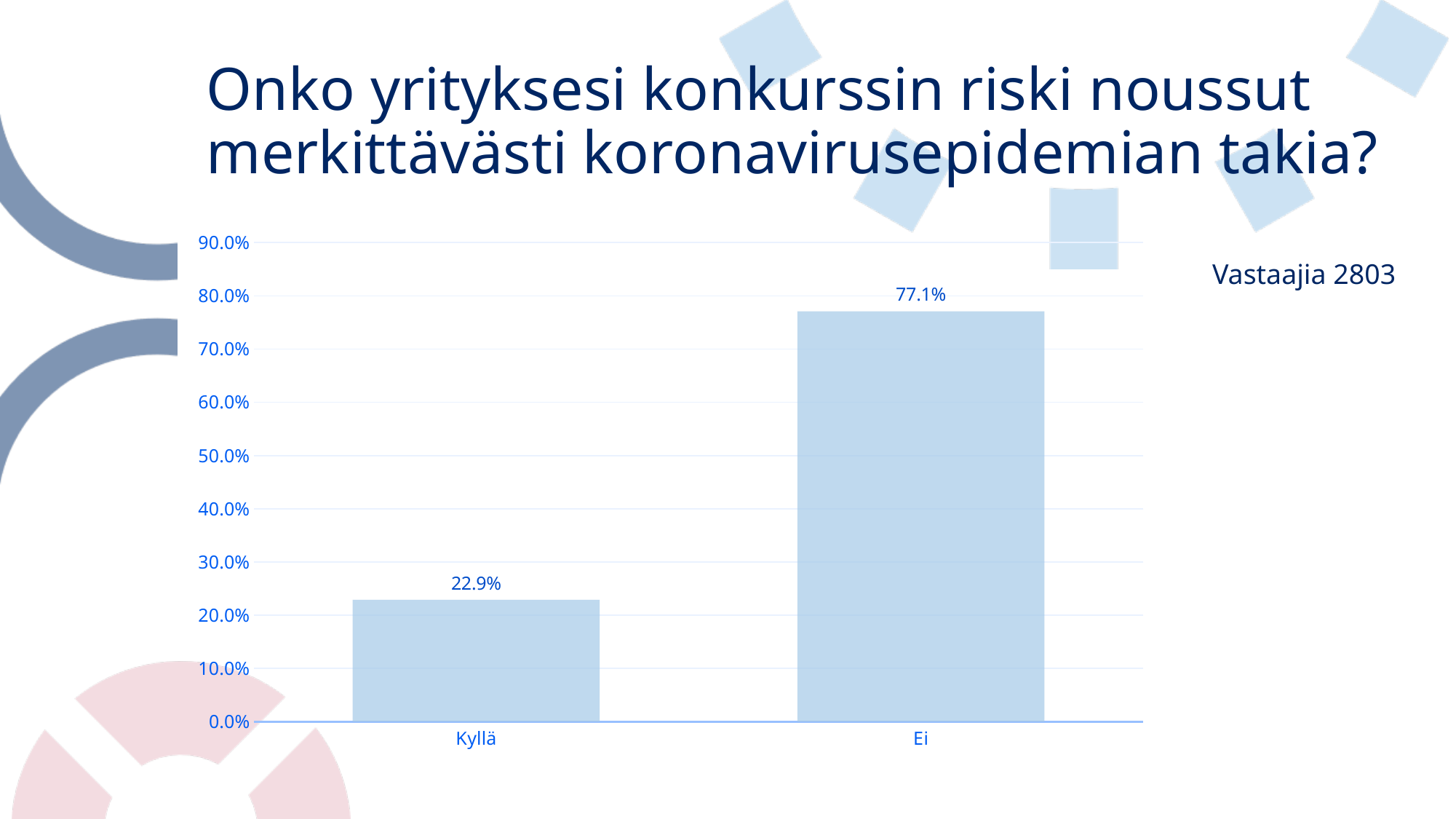
What is the total of the two bar values? 100.0% What is the value for Ei? 77.1% How many respondents (Vastaajia) does the slide report? 2803 Which category has the lowest value? Kyllä What is the difference between the values for Ei and Kyllä? 54.2% Is the value for Ei greater or less than 70.0%? greater Which is larger, the value for Kyllä or the value for Ei? Ei What is the value for Kyllä? 22.9% How many categories are shown on the x axis? 2 Is the value for Kyllä greater or less than 30.0%? less What kind of chart is shown on the slide? bar chart Which category has the highest value? Ei